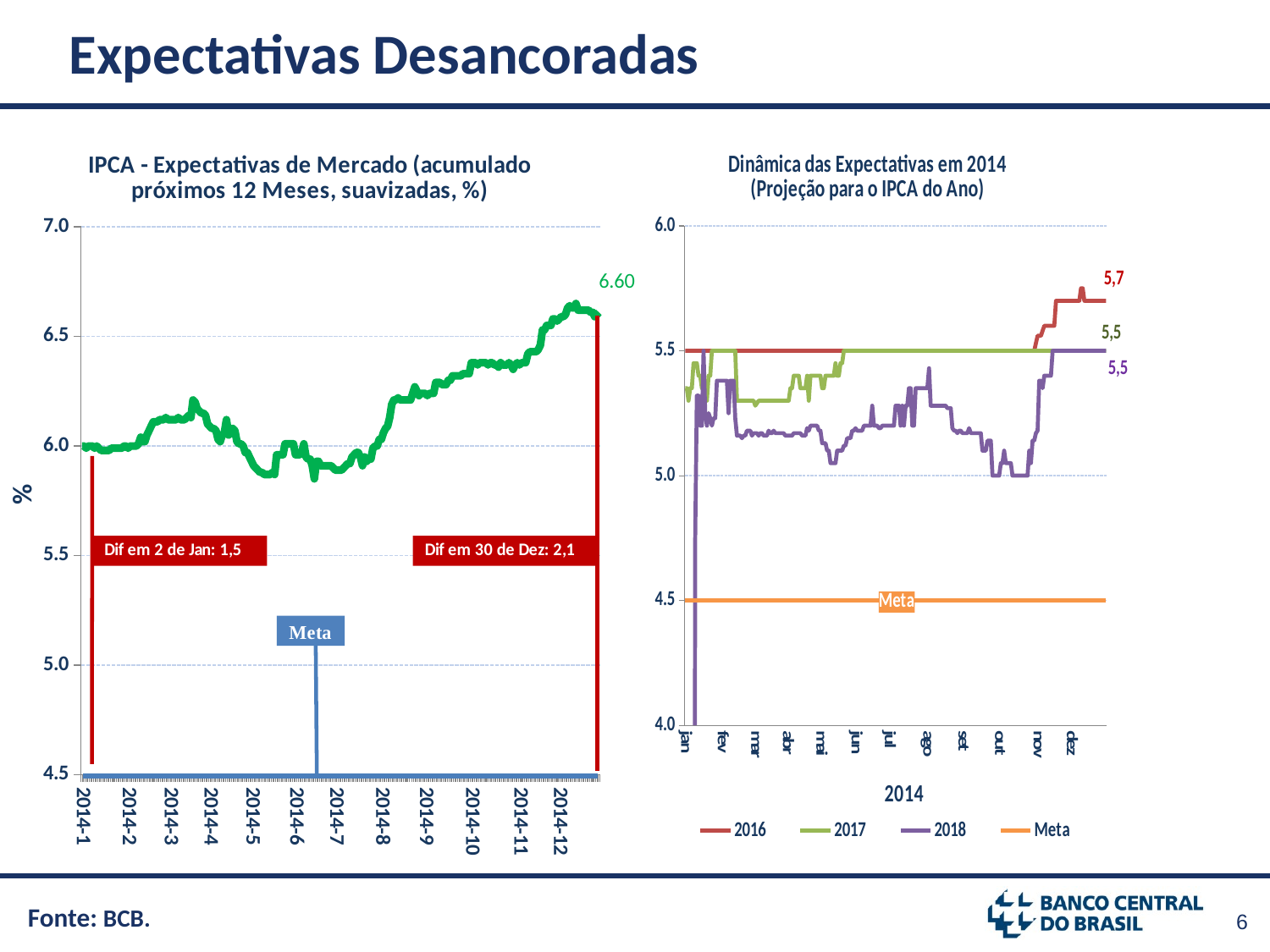
On the right chart, what is the end-of-year value labelled for the 2016 series? 5,7 On the right chart, is the 2018 series in October (out) greater or less than 5.5? less On the left chart, does the green line rise or fall between 2014-8 and 2014-12? rises On the right chart, what is the end-of-year value labelled for the 2017 series? 5,5 On the left chart, is the value around 2014-5 greater or less than 6.0? less On the left chart, what value is labelled at the end of the green line in December 2014? 6.60 How many series does the legend of the right chart, 'Dinâmica das Expectativas em 2014', list? 4 What kind of chart is the left chart, 'IPCA - Expectativas de Mercado'? line chart On the right chart, which series ends the year at the highest value? 2016 On the left chart, what is the difference stated for 2 de Jan ('Dif em 2 de Jan')? 1,5 On the right chart, what is the difference between the end-of-year values of the 2016 and 2017 series? 0,2 On the left chart, what is the difference stated for 30 de Dez ('Dif em 30 de Dez')? 2,1